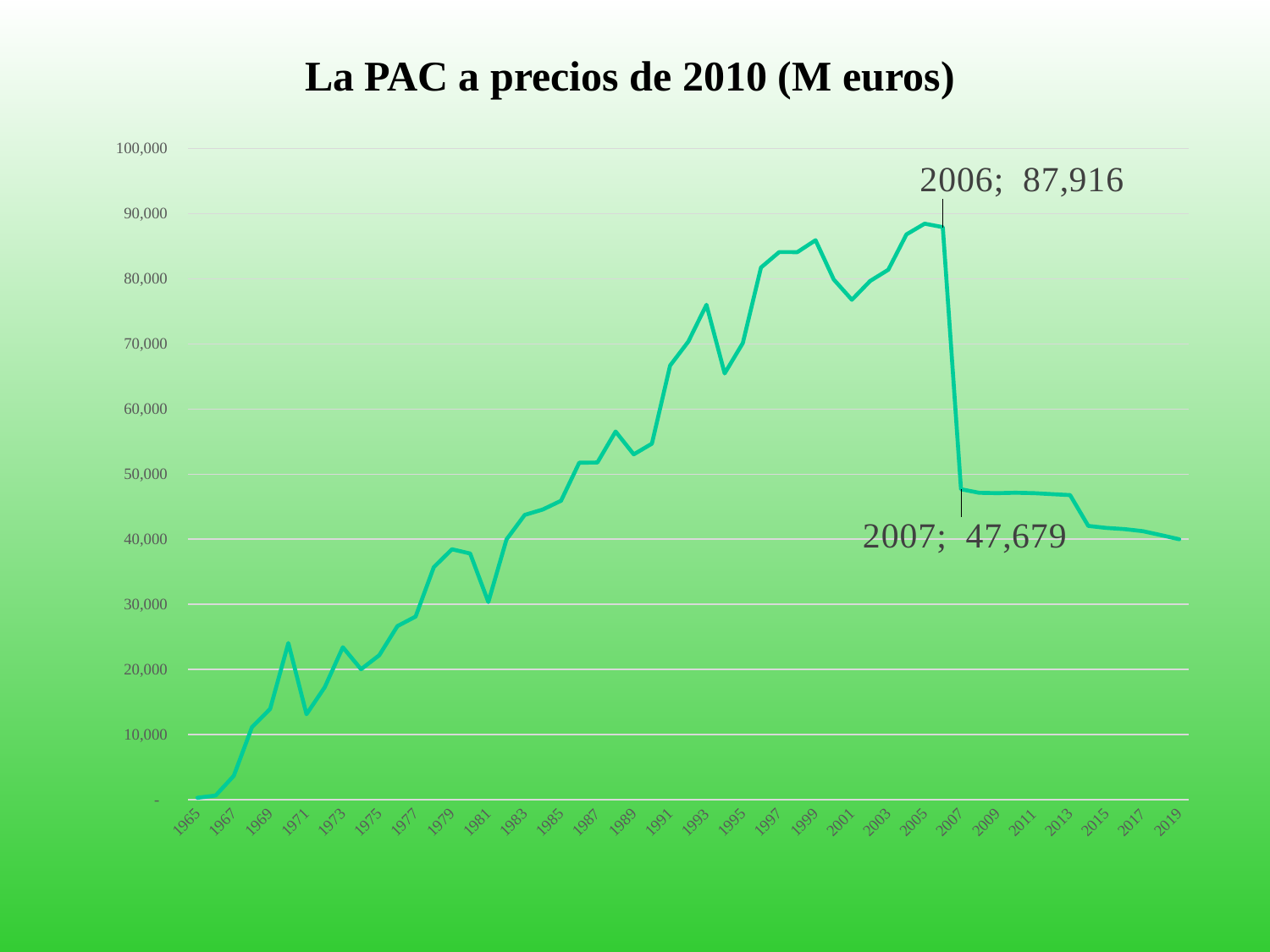
Do the values generally rise or fall from 1965 to 2006? rise What is the value for 2006? 87,916 Which year has the larger value, 2006 or 2007? 2006 Which year has the lowest value on the chart? 1965 What is the difference between the values for 2006 and 2007? 40,237 Is the value for 1993 greater or less than 70,000? greater Is the value for 1965 greater or less than 10,000? less What is the title of the chart? La PAC a precios de 2010 (M euros) Is the value for 1999 greater or less than 80,000? greater What kind of chart is shown on the slide? line chart What is the value for 2007? 47,679